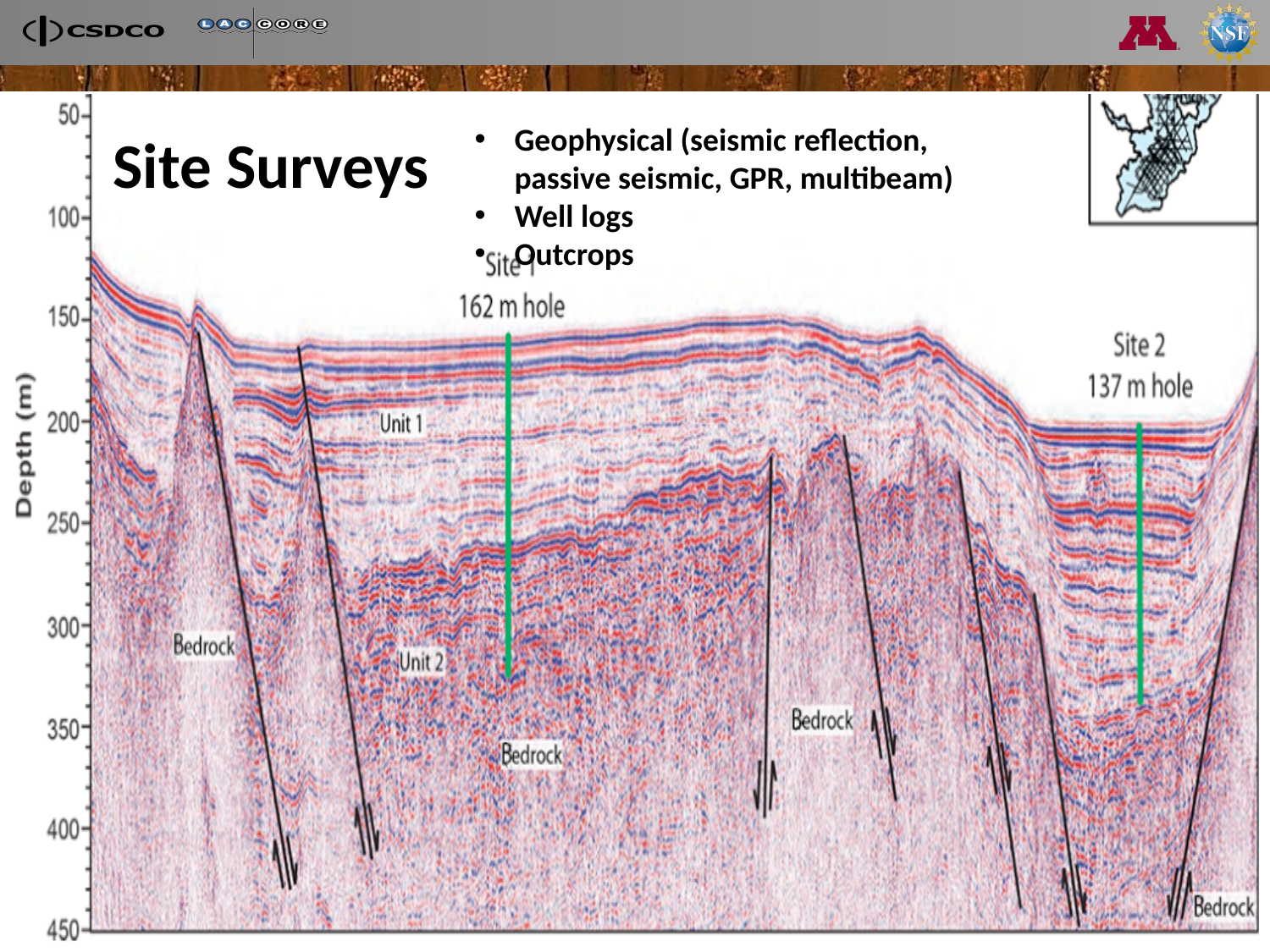
How deep is the hole at Site 1 on the seismic profile? 162 m Which site has the deeper hole, Site 1 or Site 2? Site 1 What is the label on the vertical axis of the seismic profile? Depth (m) How deep is the hole at Site 2 on the seismic profile? 137 m How many drill sites are marked on the seismic profile? 2 What is the difference in hole depth between Site 1 and Site 2? 25 m What is the largest depth value shown on the vertical axis? 450